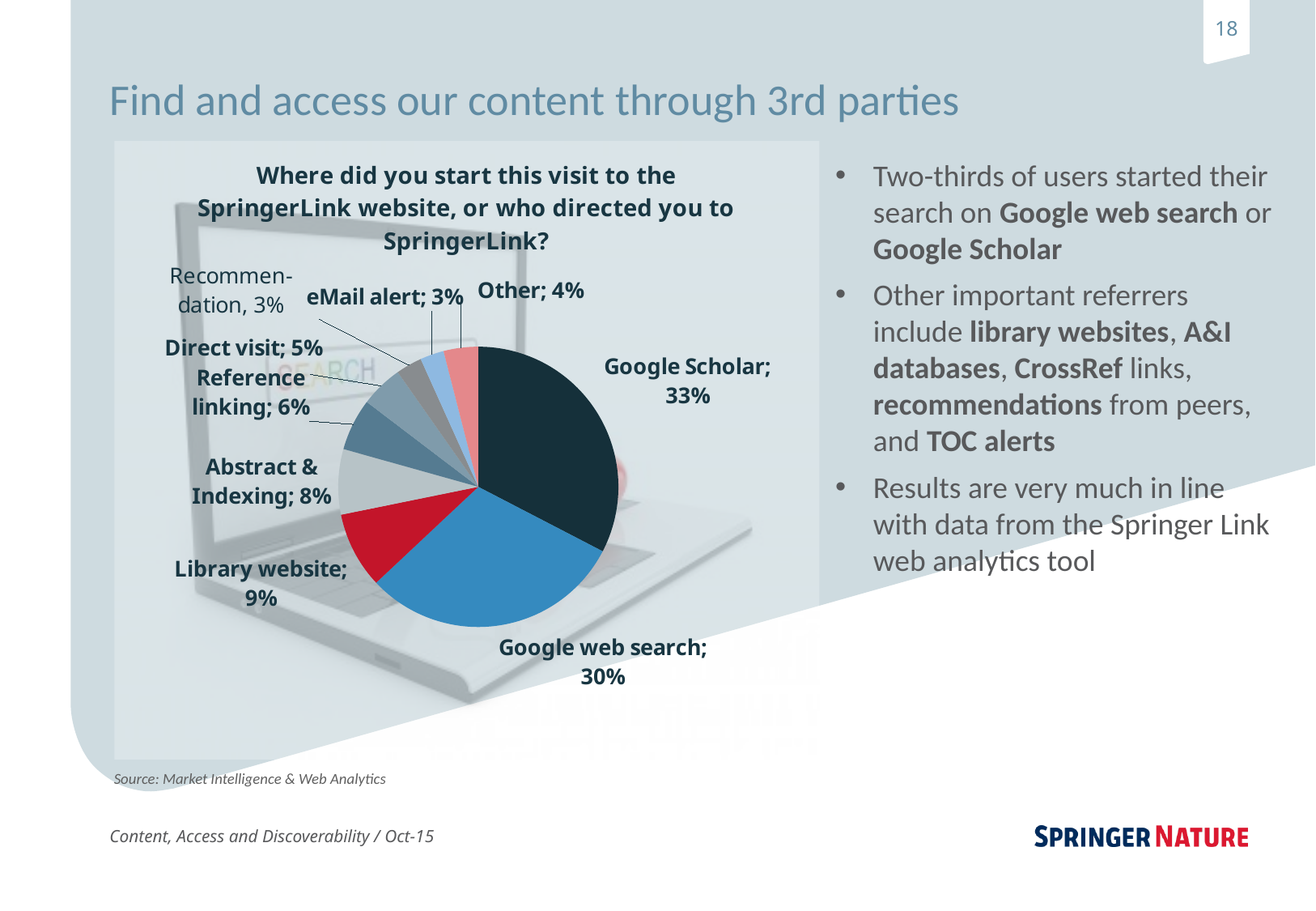
Which is larger, the Library website slice or the Direct visit slice? Library website How many slices does the pie chart have? 9 What is the combined share of Google Scholar and Google web search? 63% Which category has the largest slice of the pie? Google Scholar What share of the pie is Reference linking? 6% What is the title of the pie chart? Where did you start this visit to the SpringerLink website, or who directed you to SpringerLink? What share of the pie is Library website? 9% What share of the pie is Google web search? 30% What share of the pie is Google Scholar? 33% What kind of chart is shown on the slide? pie chart What is the difference in percentage points between Google Scholar and Google web search? 3 What share of the pie is Abstract & Indexing? 8%